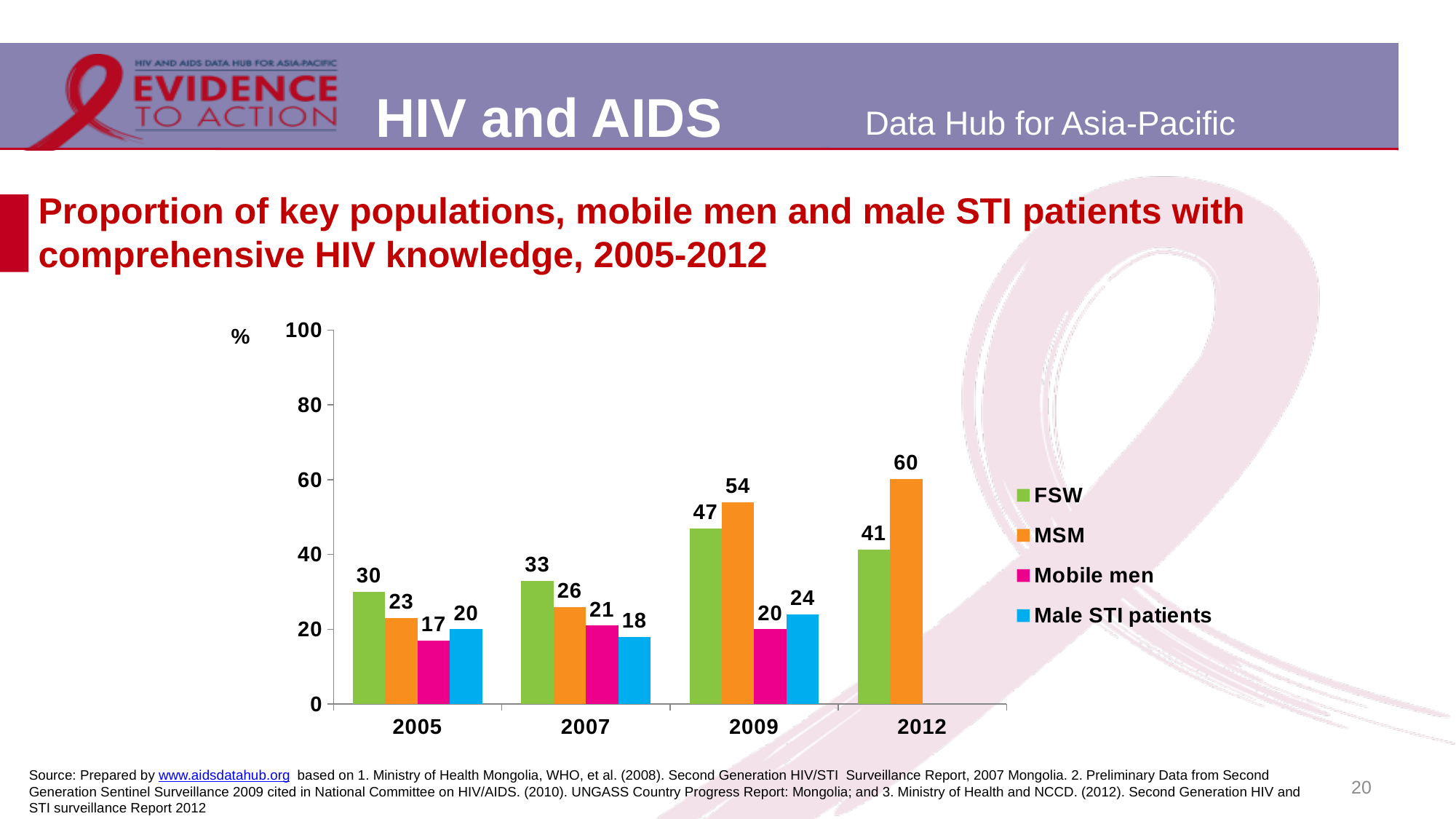
Does the FSW value rise or fall from 2005 to 2009? Rise What kind of chart is shown on the slide? Bar chart What is the value for Mobile men in 2005? 17 What is the value for FSW in 2007? 33 What is the value for Male STI patients in 2009? 24 What is the difference between the MSM and FSW values in 2012? 19 In which year is the MSM value highest? 2012 How many series does the legend list? 4 What is the value for MSM in 2012? 60 In which year is the Mobile men value lowest? 2005 How many years are shown on the x axis? 4 Which is larger in 2009: the FSW value or the MSM value? MSM